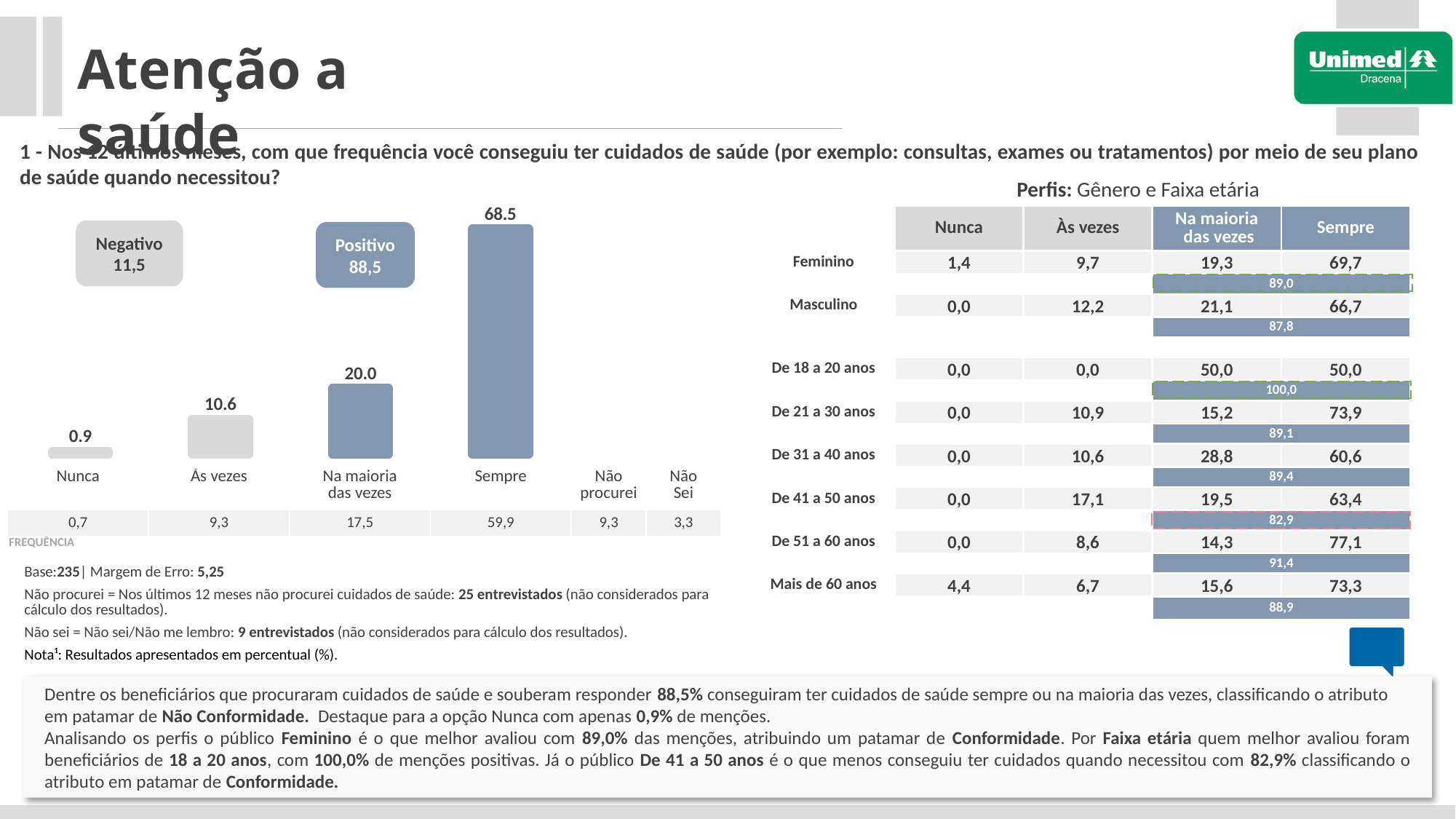
Which category has the highest bar in the bar chart? Sempre Which category has the lowest bar in the bar chart? Nunca In the bar chart, which is larger: the value for Às vezes or the value for Na maioria das vezes? Na maioria das vezes In the bar chart, what is the value for Na maioria das vezes? 20.0 Do the bar values rise or fall from Nunca to Sempre along the x axis? Rise In the bar chart, what is the value for Às vezes? 10.6 In the bar chart, what is the difference between the values for Sempre and Na maioria das vezes? 48.5 In the bar chart, what is the value for Nunca? 0.9 How many bars are plotted in the bar chart? 4 What kind of chart is shown on the left of the slide? Bar chart In the bar chart, what is the difference between the values for Na maioria das vezes and Às vezes? 9.4 In the bar chart, what is the value for Sempre? 68.5